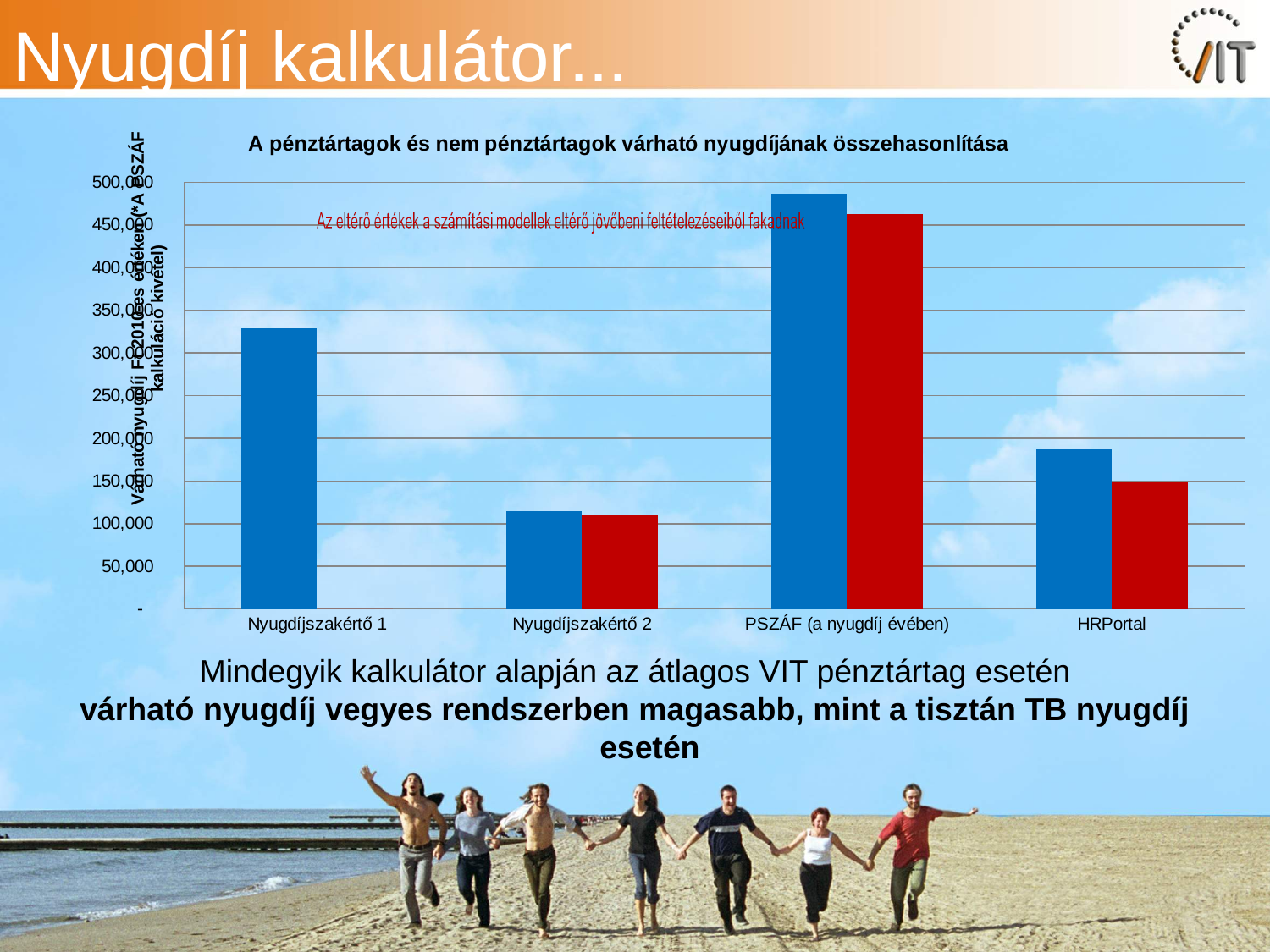
How many categories are shown on the x axis of the chart? 4 Which category has only a blue bar and no red bar? Nyugdíjszakértő 1 For HRPortal, which bar is taller, the blue one or the red one? the blue one Which category has the tallest blue bar? PSZÁF (a nyugdíj évében) Which is larger: the blue bar for Nyugdíjszakértő 1 or the blue bar for HRPortal? Nyugdíjszakértő 1 What kind of chart is shown on the slide? bar chart Which category has the shortest blue bar? Nyugdíjszakértő 2 Is the blue bar for Nyugdíjszakértő 2 greater or less than 150,000? less Is the red bar for HRPortal greater or less than 200,000? less Is the blue bar for Nyugdíjszakértő 1 greater or less than 300,000? greater What is the title of the chart? A pénztártagok és nem pénztártagok várható nyugdíjának összehasonlítása